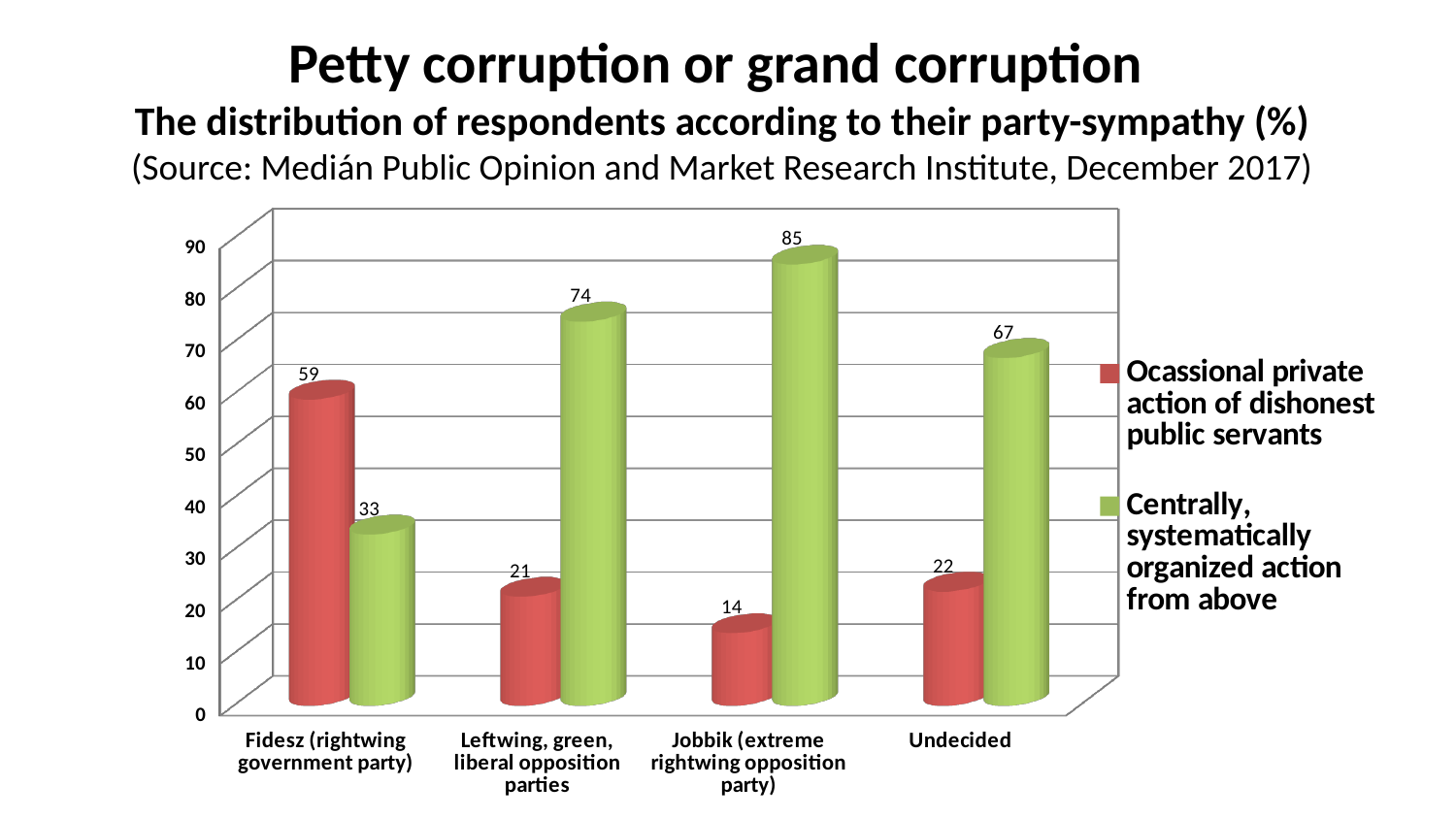
What kind of chart is shown on the slide? Bar chart What is the value for 'Ocassional private action of dishonest public servants' for Fidesz (rightwing government party)? 59 For Undecided, which series has the larger value? Centrally, systematically organized action from above How many series does the legend list? 2 What is the value for 'Centrally, systematically organized action from above' for Undecided? 67 Which category has the lowest value for 'Ocassional private action of dishonest public servants'? Jobbik (extreme rightwing opposition party) What colour are the bars for 'Centrally, systematically organized action from above'? Green What is the value for 'Ocassional private action of dishonest public servants' for Leftwing, green, liberal opposition parties? 21 Which category has the highest value for 'Centrally, systematically organized action from above'? Jobbik (extreme rightwing opposition party) How many party categories are shown on the x axis? 4 What is the difference between the two series values for Fidesz (rightwing government party)? 26 What is the value for 'Centrally, systematically organized action from above' for Jobbik (extreme rightwing opposition party)? 85